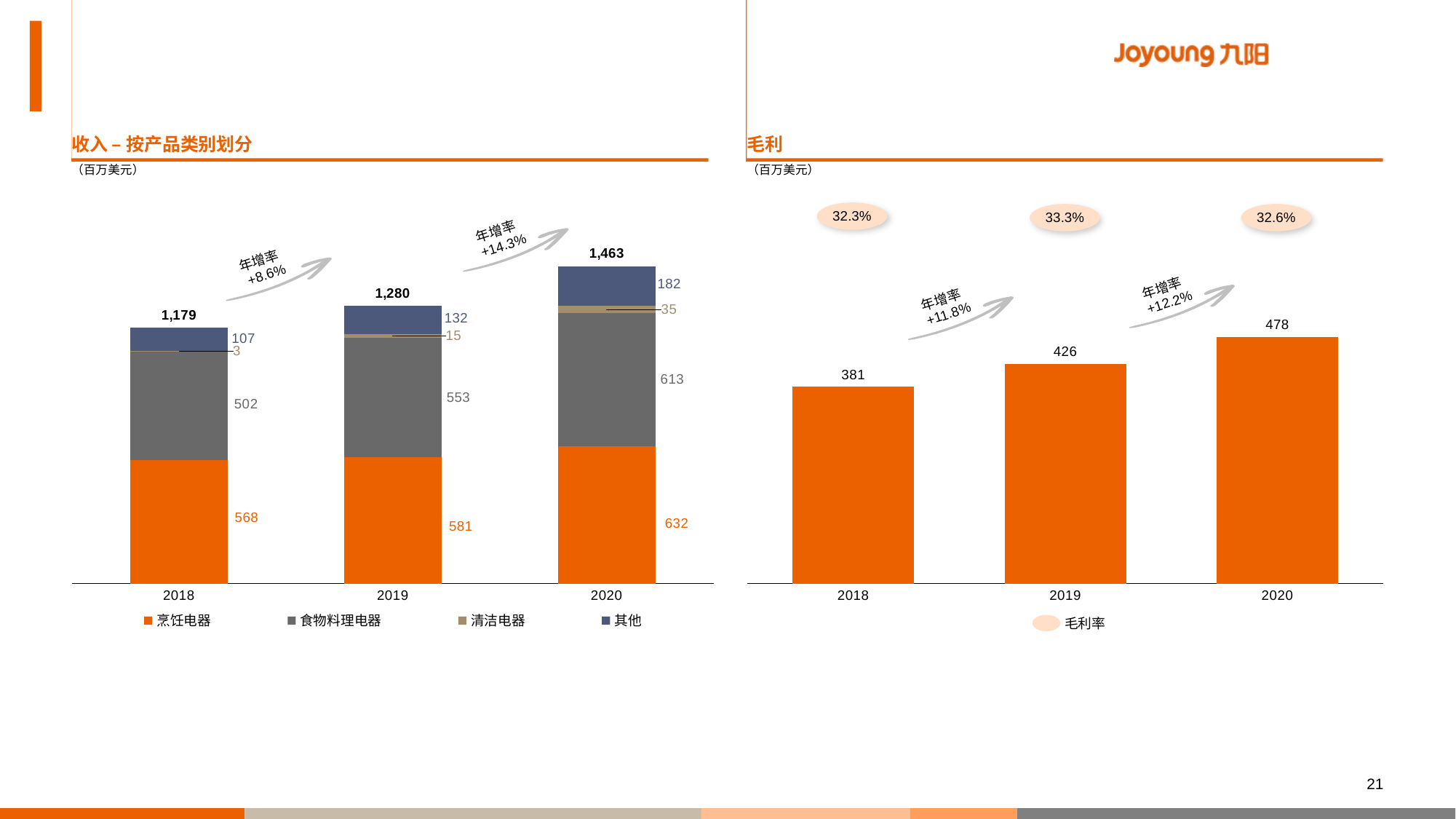
In the 毛利 chart, what is the value for 2019? 426 In the 毛利 chart, do the values rise or fall from 2018 to 2020? Rise In the 收入 – 按产品类别划分 chart, which year has the highest total revenue? 2020 In the 毛利 chart, what is the difference between the values for 2020 and 2018? 97 In the 收入 – 按产品类别划分 chart, what is the difference between the 其他 values for 2020 and 2018? 75 In the 收入 – 按产品类别划分 chart, what is the value for 食物料理电器 in 2019? 553 In the 收入 – 按产品类别划分 chart, what is the total of the stacked bar for 2018? 1,179 In the 收入 – 按产品类别划分 chart, how many series does the legend list? 4 In the 收入 – 按产品类别划分 chart, which is larger in 2019: 烹饪电器 or 食物料理电器? 烹饪电器 In the 毛利 chart, which year has the lowest value? 2018 In the 收入 – 按产品类别划分 chart, what is the value for 烹饪电器 in 2020? 632 In the 收入 – 按产品类别划分 chart, what kind of chart is shown? Stacked bar chart